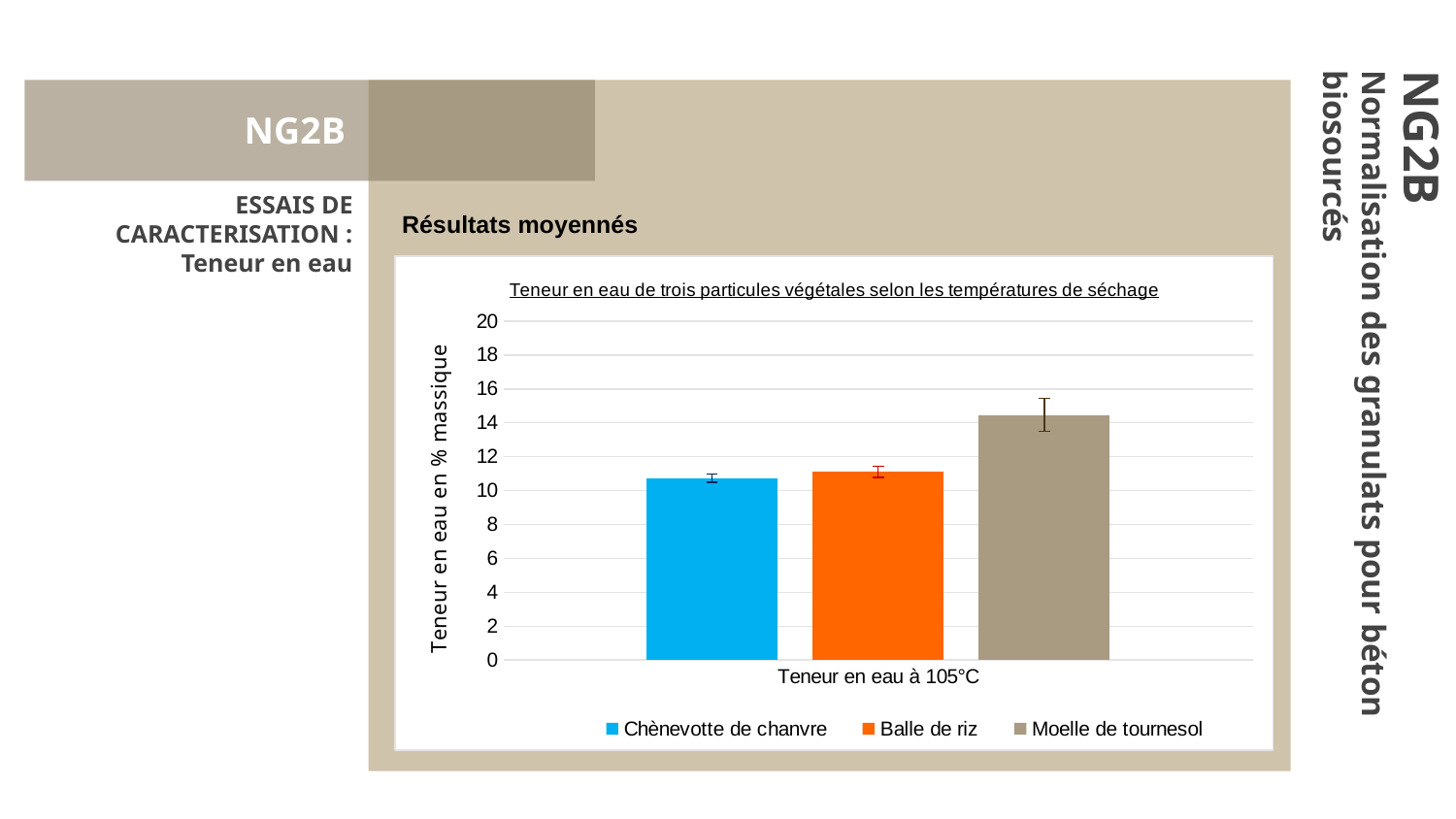
What is the title of the chart? Teneur en eau de trois particules végétales selon les températures de séchage Is the value for Chènevotte de chanvre greater or less than 12? less Which series has the lowest water content (teneur en eau)? Chènevotte de chanvre Which has a higher water content, Moelle de tournesol or Chènevotte de chanvre? Moelle de tournesol What kind of chart is shown on the slide? bar chart How many categories are shown on the x axis? 1 Is the value for Balle de riz greater or less than 10? greater How many series does the legend list? 3 Which has a higher water content, Balle de riz or Moelle de tournesol? Moelle de tournesol Which series has the highest water content (teneur en eau)? Moelle de tournesol Is the value for Moelle de tournesol greater or less than 12? greater What is the label of the y axis? Teneur en eau en % massique